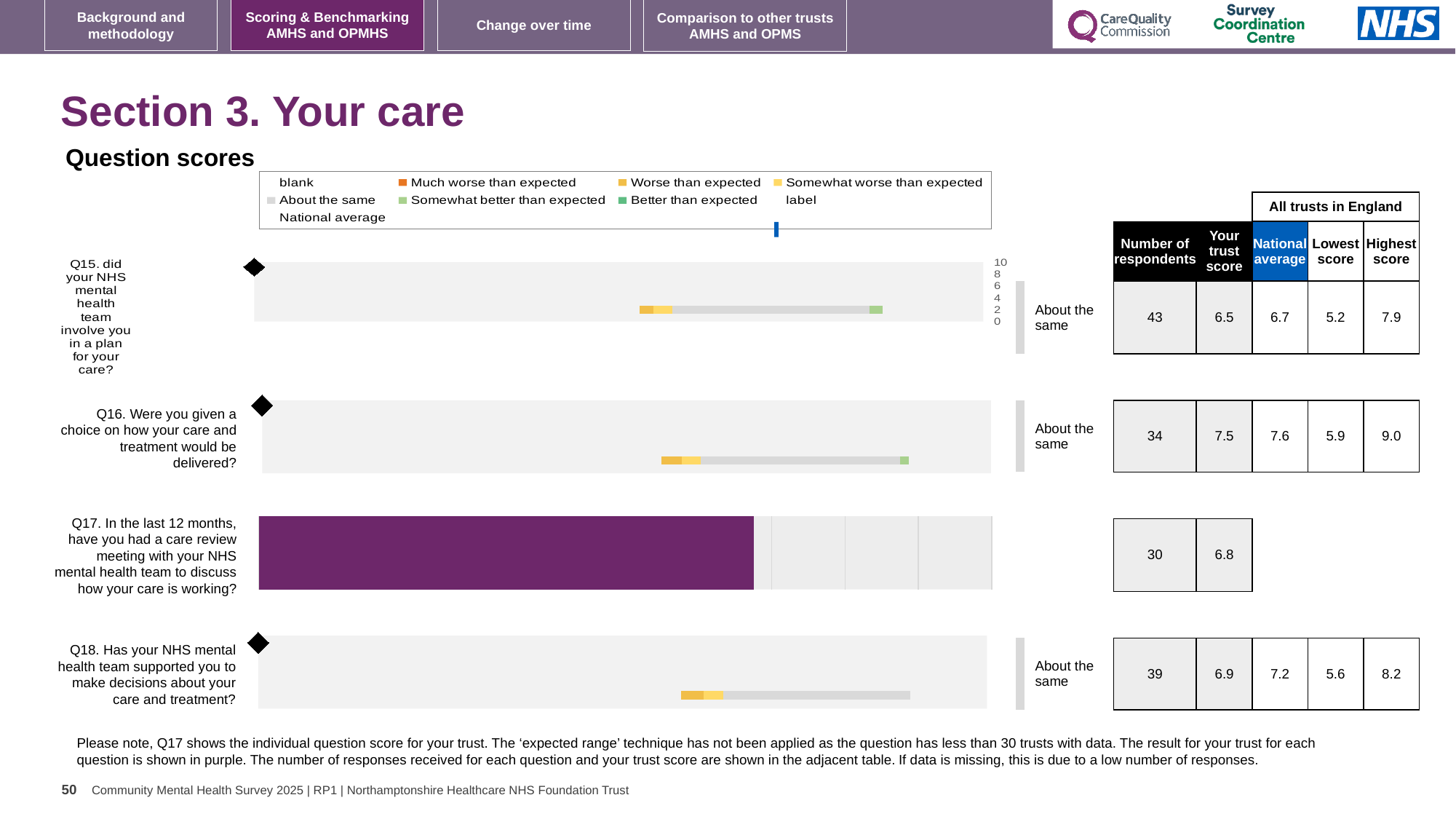
What is the difference between the national average and the trust score for Q18? 0.3 Which question is shown as a purple bar because the expected range technique has not been applied? Q17 What is the highest score among all trusts in England for Q18? 8.2 How many respondents answered Q15 (did your NHS mental health team involve you in a plan for your care)? 43 What is the trust score for Q16 (Were you given a choice on how your care and treatment would be delivered)? 7.5 How many questions are plotted in the Question scores chart? 4 Which has the larger trust score, Q15 or Q18? Q18 What is the lowest score among all trusts in England for Q16? 5.9 What is the difference between the highest and lowest scores among all trusts in England for Q16? 3.1 Which question has the highest trust score? Q16 Which question has the lowest trust score? Q15 What benchmark category is shown for Q15? About the same